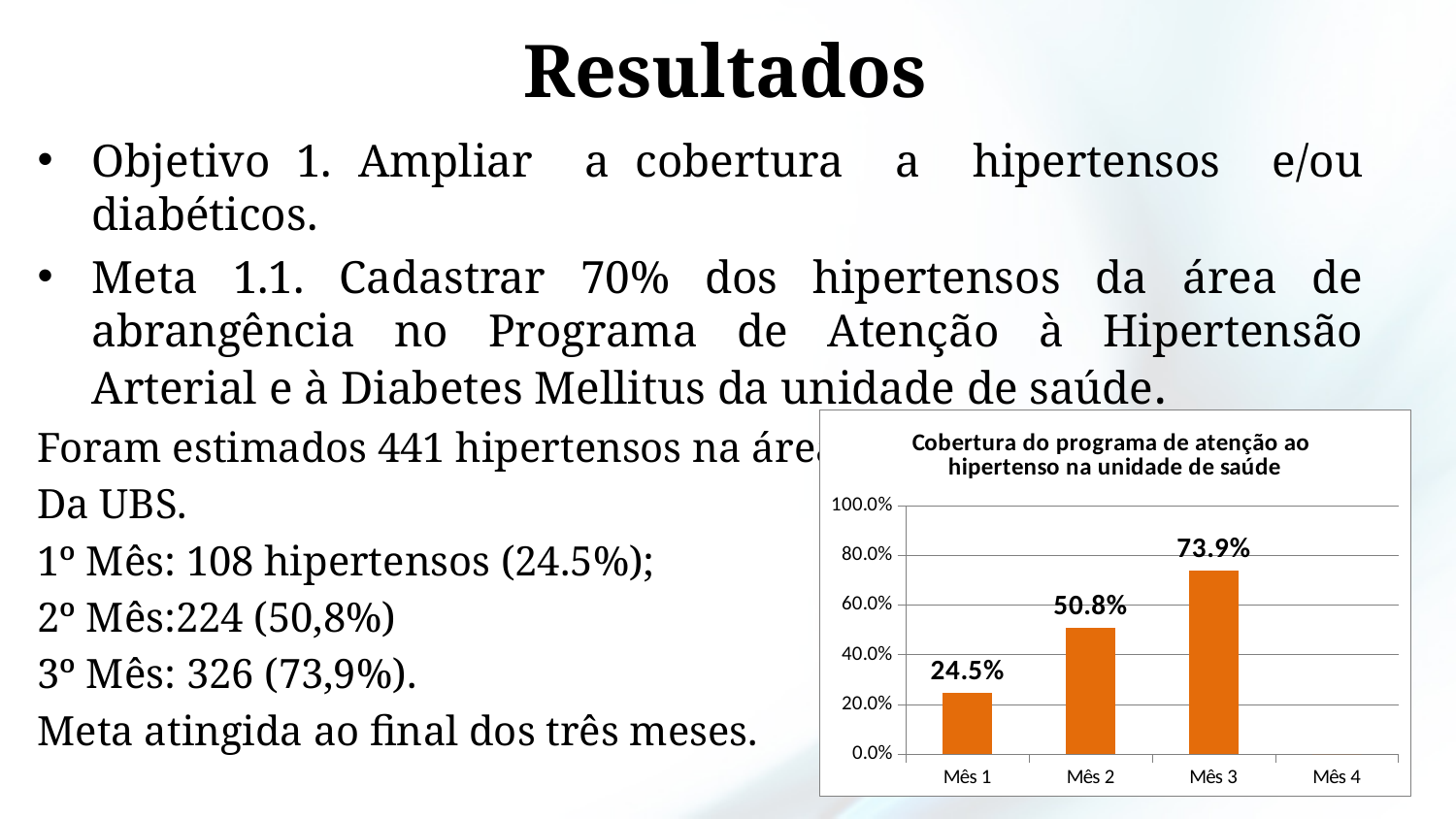
What is the difference between the values for Mês 2 and Mês 1? 26.3% Among the months with a plotted bar, which has the lowest value? Mês 1 Which month has the highest value in the chart? Mês 3 Which is larger, the value for Mês 2 or the value for Mês 3? Mês 3 What kind of chart is shown on the slide? bar chart What is the difference between the values for Mês 3 and Mês 1? 49.4% What is the value for Mês 2 in the chart? 50.8% Is the value for Mês 3 greater or less than 60.0%? greater What is the value for Mês 1 in the chart? 24.5% What is the value for Mês 3 in the chart? 73.9% How many bars are plotted in the chart? 3 What is the title of the chart? Cobertura do programa de atenção ao hipertenso na unidade de saúde